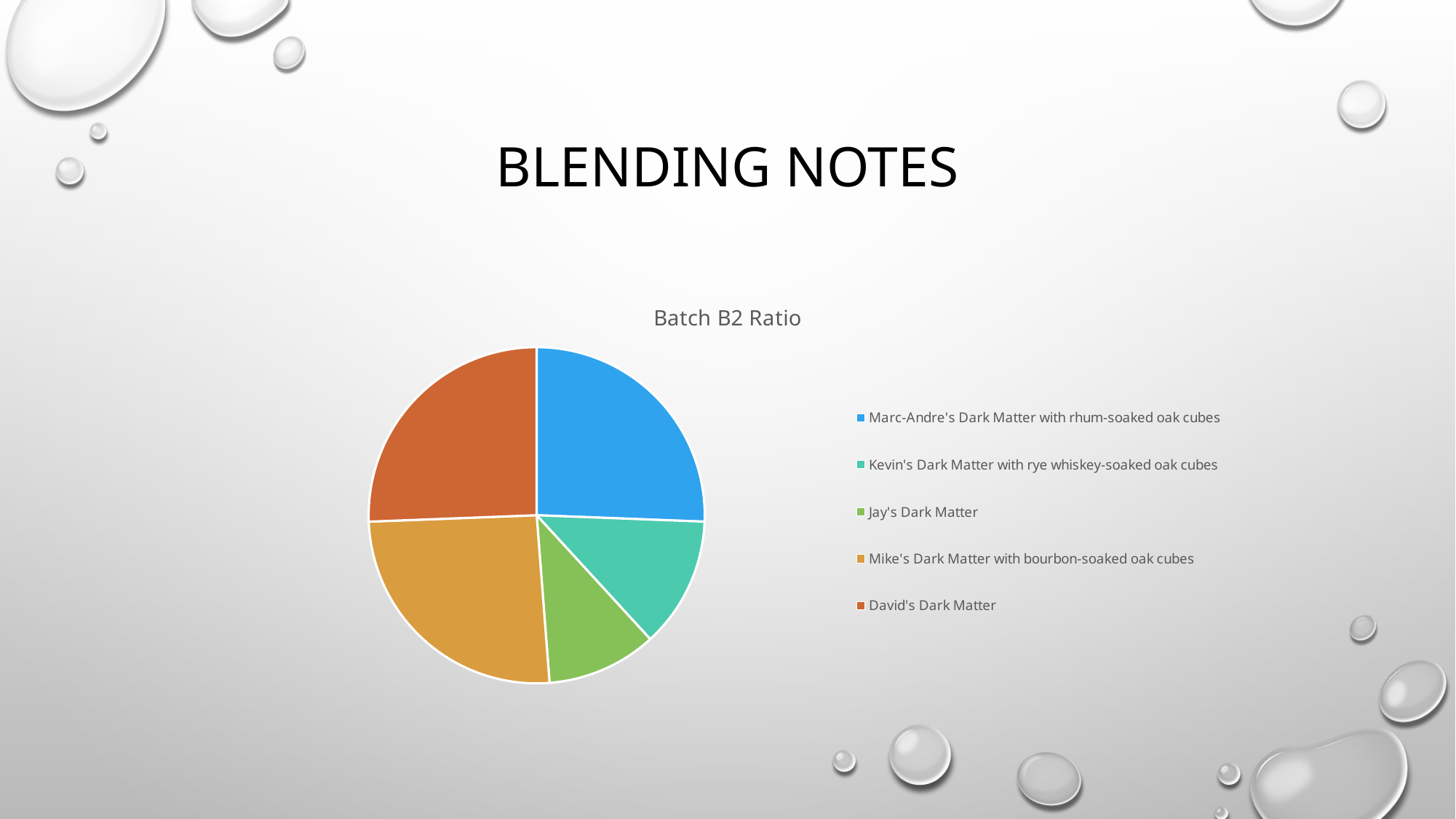
What colour is the slice for Jay's Dark Matter? green Which slice is larger: Jay's Dark Matter or David's Dark Matter? David's Dark Matter What kind of chart is shown on the slide? pie chart Which slice is larger: Mike's Dark Matter with bourbon-soaked oak cubes or Jay's Dark Matter? Mike's Dark Matter with bourbon-soaked oak cubes Which slice is larger: Marc-Andre's Dark Matter with rhum-soaked oak cubes or Kevin's Dark Matter with rye whiskey-soaked oak cubes? Marc-Andre's Dark Matter with rhum-soaked oak cubes How many entries does the legend list? 5 How many slices does the pie chart have? 5 What is the title of the chart? Batch B2 Ratio